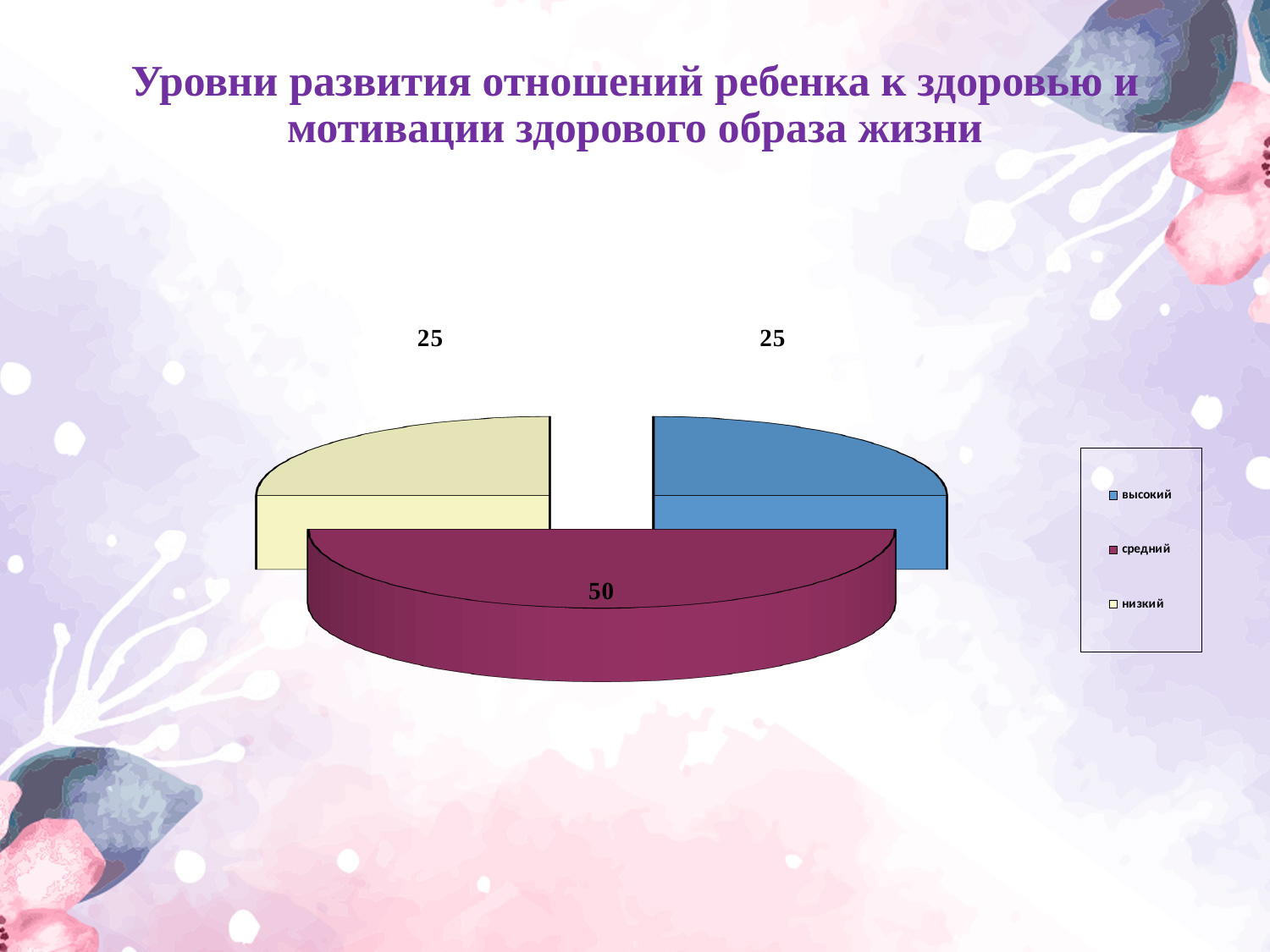
Which category has the largest slice? средний What colour is the "высокий" slice? blue How many slices does the pie chart have? 3 How many entries does the legend list? 3 What is the title of the slide? Уровни развития отношений ребенка к здоровью и мотивации здорового образа жизни Which is larger, the value for "средний" or the value for "низкий"? средний What is the value for the "средний" slice? 50 What is the value for the "низкий" slice? 25 What share of the pie does the "средний" slice represent? 50% What is the value for the "высокий" slice? 25 What kind of chart is shown on the slide? pie chart What is the difference between the values for "средний" and "высокий"? 25